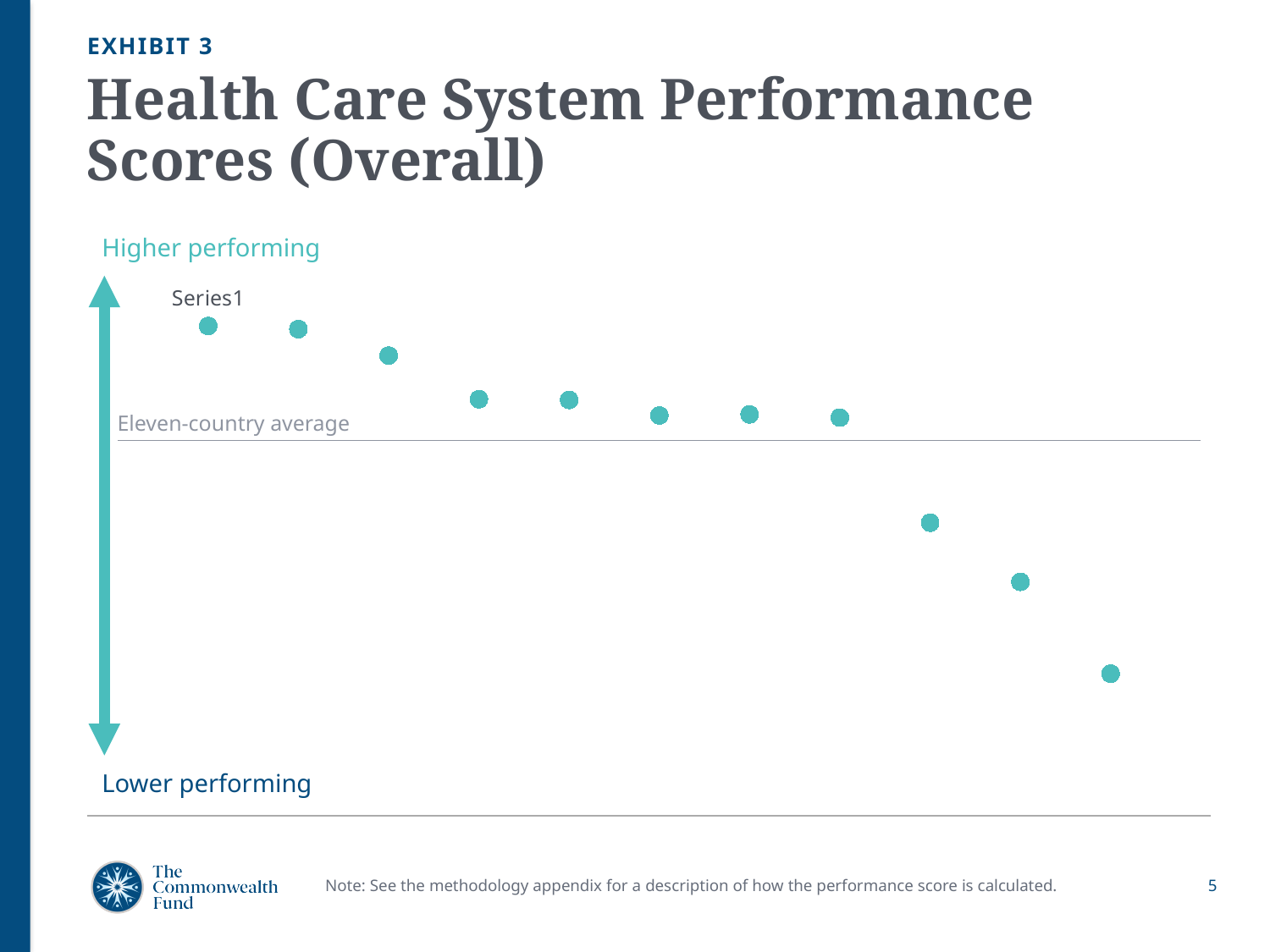
How many data points lie below the 'Eleven-country average' line? 3 Is the leftmost data point above or below the eleven-country average line? Above Is the rightmost data point above or below the eleven-country average line? Below What kind of chart is shown on the slide? Scatter (dot) chart How many data points lie above the 'Eleven-country average' line? 8 How many series does the chart's legend list? 1 What is the title of the chart on the slide? Health Care System Performance Scores (Overall) Do the plotted values rise or fall from left to right along the x axis? Fall How many data points are plotted on the chart? 11 What label is given to the horizontal reference line on the chart? Eleven-country average Which data point is the lowest on the chart: the leftmost or the rightmost? The rightmost What is the name of the series shown in the chart legend? Series1